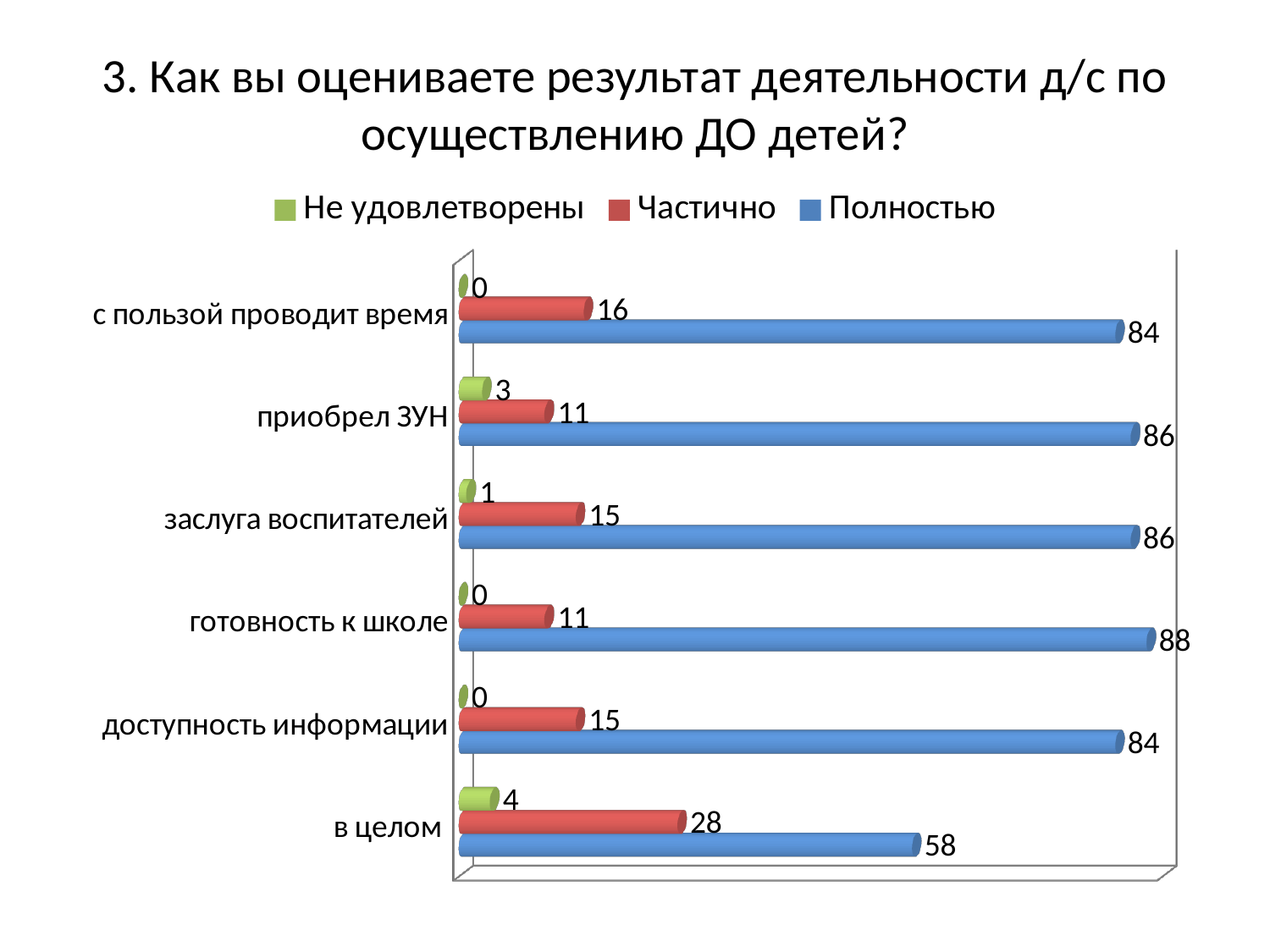
Which category has the highest value in the "Частично" series? в целом What is the difference between the "Полностью" values for "готовность к школе" and "в целом"? 30 What is the value of the "Не удовлетворены" series for "приобрел ЗУН"? 3 Which category has the lowest value in the "Полностью" series? в целом What kind of chart is shown on the slide? Bar chart What is the value of the "Полностью" series for "готовность к школе"? 88 What is the value of the "Частично" series for "в целом"? 28 How many series does the legend list? 3 Which is larger: the "Частично" value for "с пользой проводит время" or for "приобрел ЗУН"? с пользой проводит время Which series is shown in blue? Полностью Which category has the highest value in the "Полностью" series? готовность к школе How many categories are shown on the chart? 6